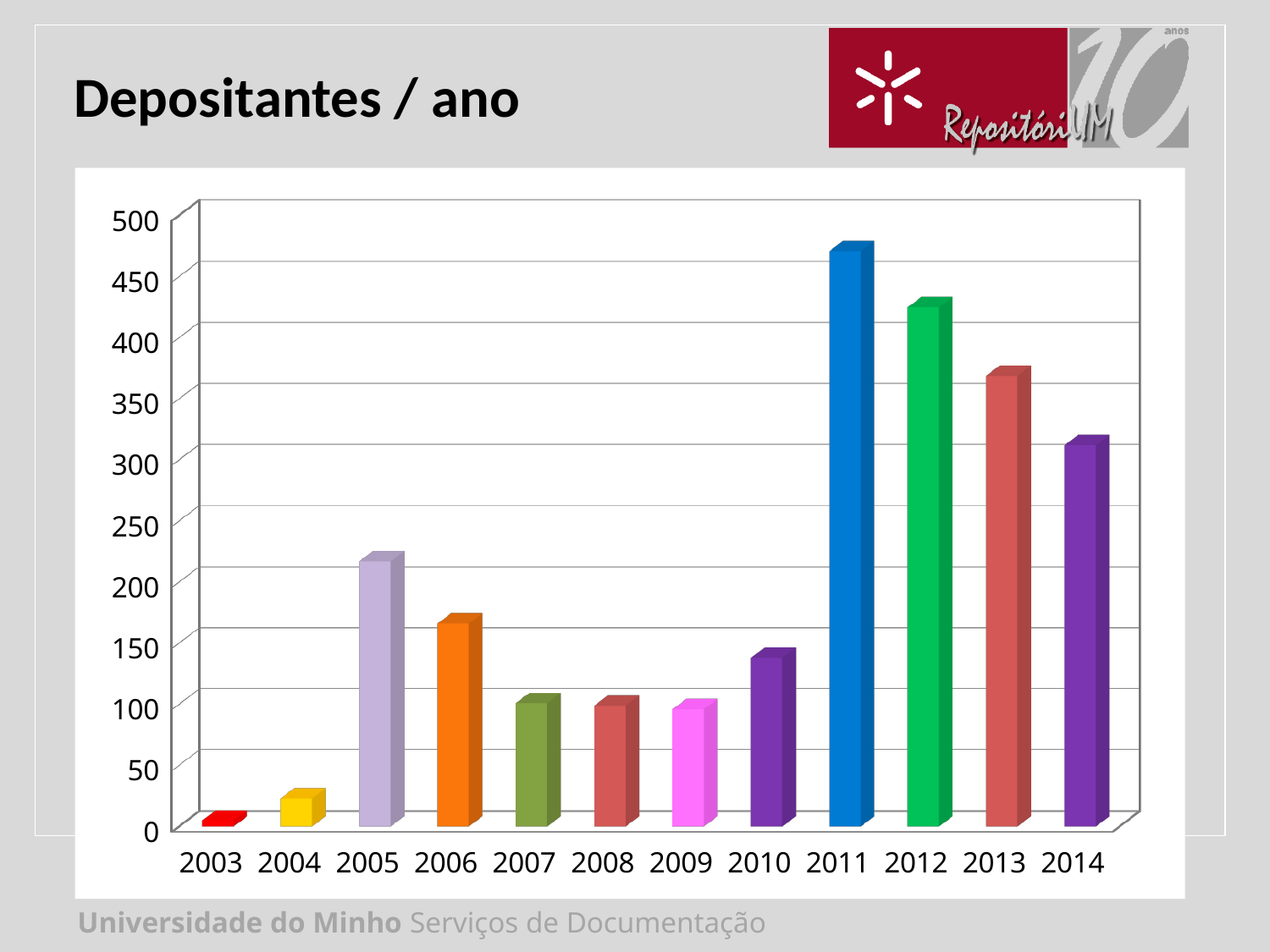
What kind of chart is shown on the slide? bar chart Which year has the larger value, 2005 or 2006? 2005 Which year has the highest value in the chart? 2011 Is the value for 2004 greater or less than 50? less Which year has the lowest value in the chart? 2003 Is the value for 2005 greater or less than 200? greater What is the title of the chart on the slide? Depositantes / ano Is the value for 2011 greater or less than 450? greater How many years are shown on the x axis of the chart? 12 Do the values rise or fall from 2011 to 2014? fall